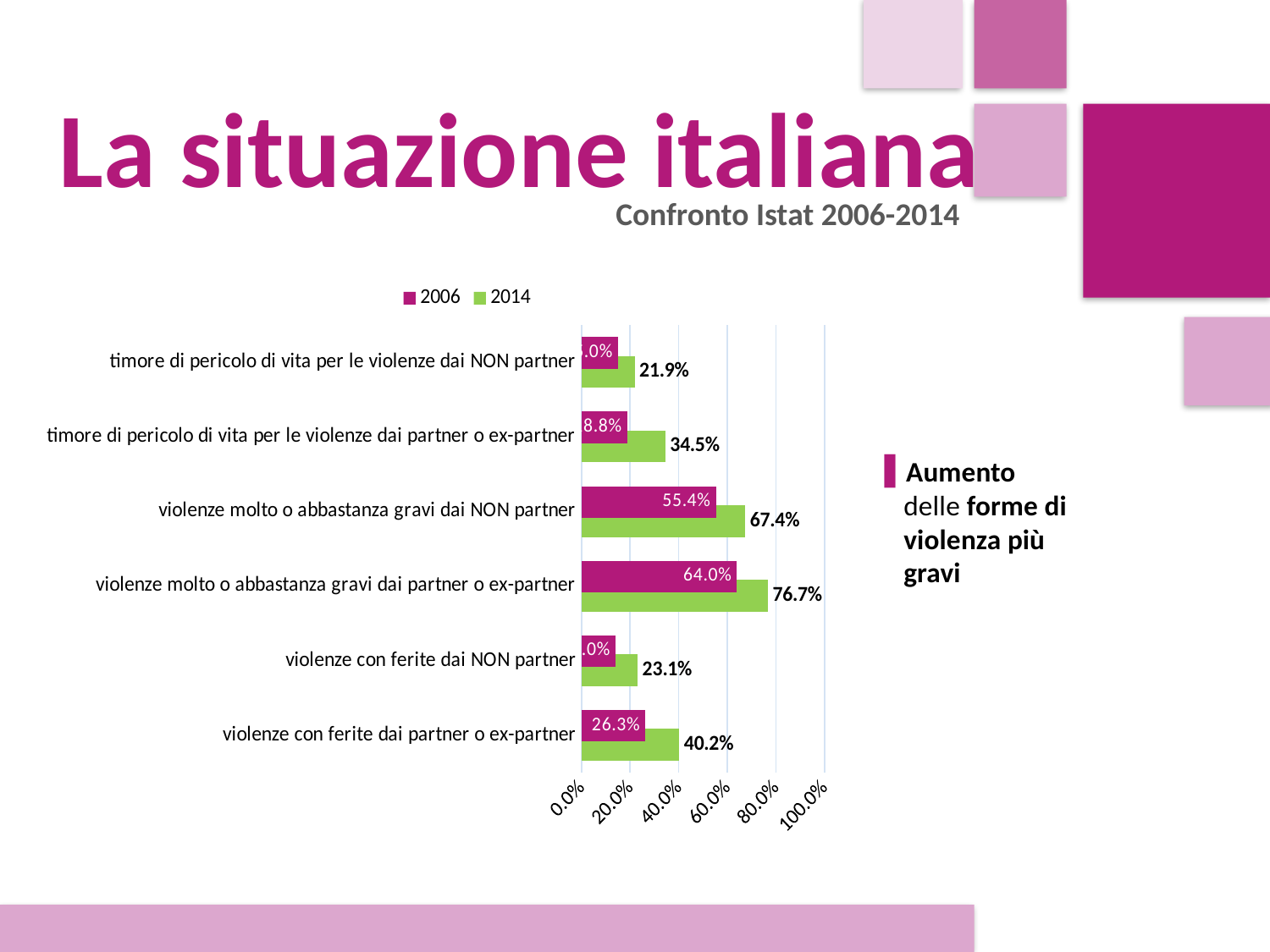
Which is larger: the 2014 value for "violenze con ferite dai NON partner" or the 2014 value for "violenze con ferite dai partner o ex-partner"? violenze con ferite dai partner o ex-partner How many categories are shown in the chart? 6 Which category has the highest 2014 value? violenze molto o abbastanza gravi dai partner o ex-partner What is the 2014 value for "violenze con ferite dai partner o ex-partner"? 40.2% How many series does the legend list? 2 Is the 2006 value for "timore di pericolo di vita per le violenze dai NON partner" greater or less than 20.0%? less What is the difference between the 2014 and 2006 values for "violenze con ferite dai partner o ex-partner"? 13.9% What is the 2006 value for "violenze molto o abbastanza gravi dai NON partner"? 55.4% Which category has the lowest 2014 value? timore di pericolo di vita per le violenze dai NON partner What is the difference between the 2014 and 2006 values for "violenze molto o abbastanza gravi dai NON partner"? 12.0% What is the 2014 value for "violenze molto o abbastanza gravi dai partner o ex-partner"? 76.7% What is the 2006 value for "violenze con ferite dai partner o ex-partner"? 26.3%